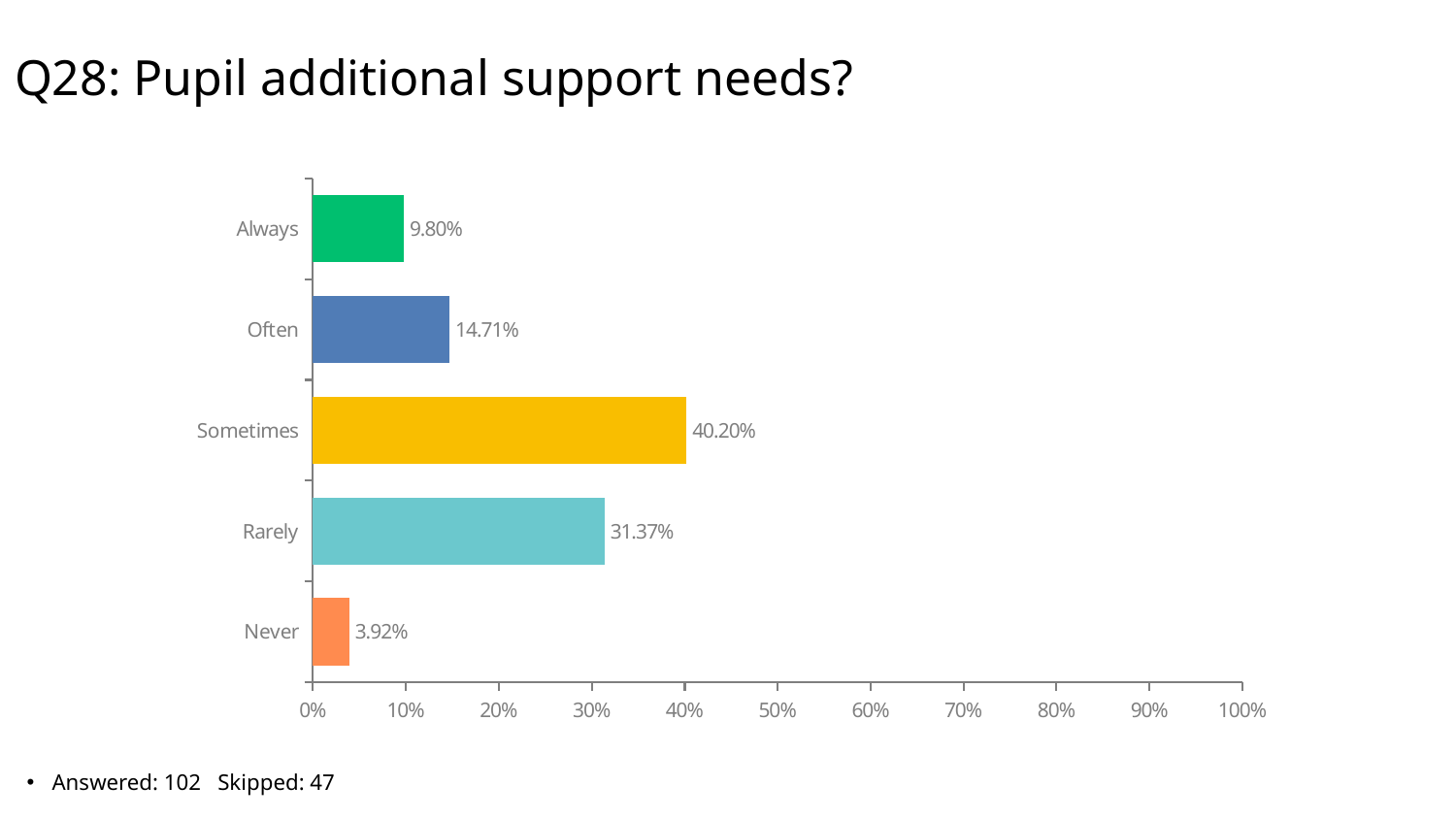
How many categories are shown in the chart? 5 What is the difference between the values for Often and Always? 4.91% Which category has the lowest value? Never What is the title of the slide? Q28: Pupil additional support needs? Is the value for Rarely greater or less than 30%? greater What kind of chart is shown on the slide? Bar chart What is the value for Never? 3.92% What percentage is shown for Often? 14.71% Which category has the highest value? Sometimes Which is larger, the value for Rarely or the value for Often? Rarely What is the difference between the values for Sometimes and Rarely? 8.83% What percentage is shown for Sometimes? 40.20%